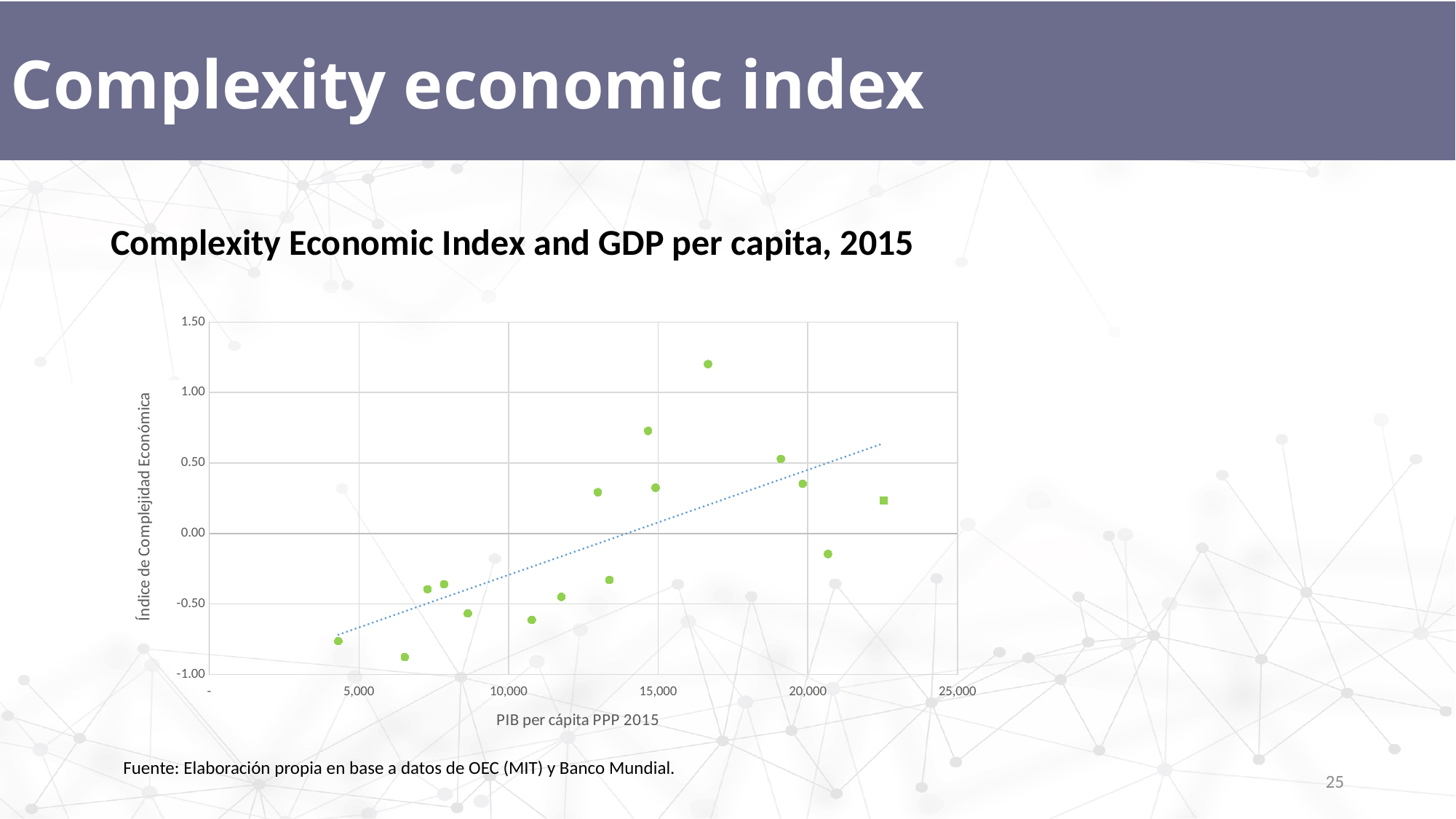
How many points have a Complexity Economic Index below 0.00? 9 What is the title of the chart? Complexity Economic Index and GDP per capita, 2015 Does the dotted trend line rise or fall as GDP per capita increases? Rises Is the lowest Complexity Economic Index value on the chart greater or less than -0.50? less What is the maximum value shown on the vertical axis? 1.50 How many points have a Complexity Economic Index above 0.50? 3 Is the GDP per capita of the point with the lowest Complexity Economic Index greater or less than 10,000? less Is the GDP per capita of the point with the highest Complexity Economic Index greater or less than 15,000? greater How many data points are plotted on the chart? 16 What is the label of the horizontal axis? PIB per cápita PPP 2015 What kind of chart is shown on the slide? Scatter chart